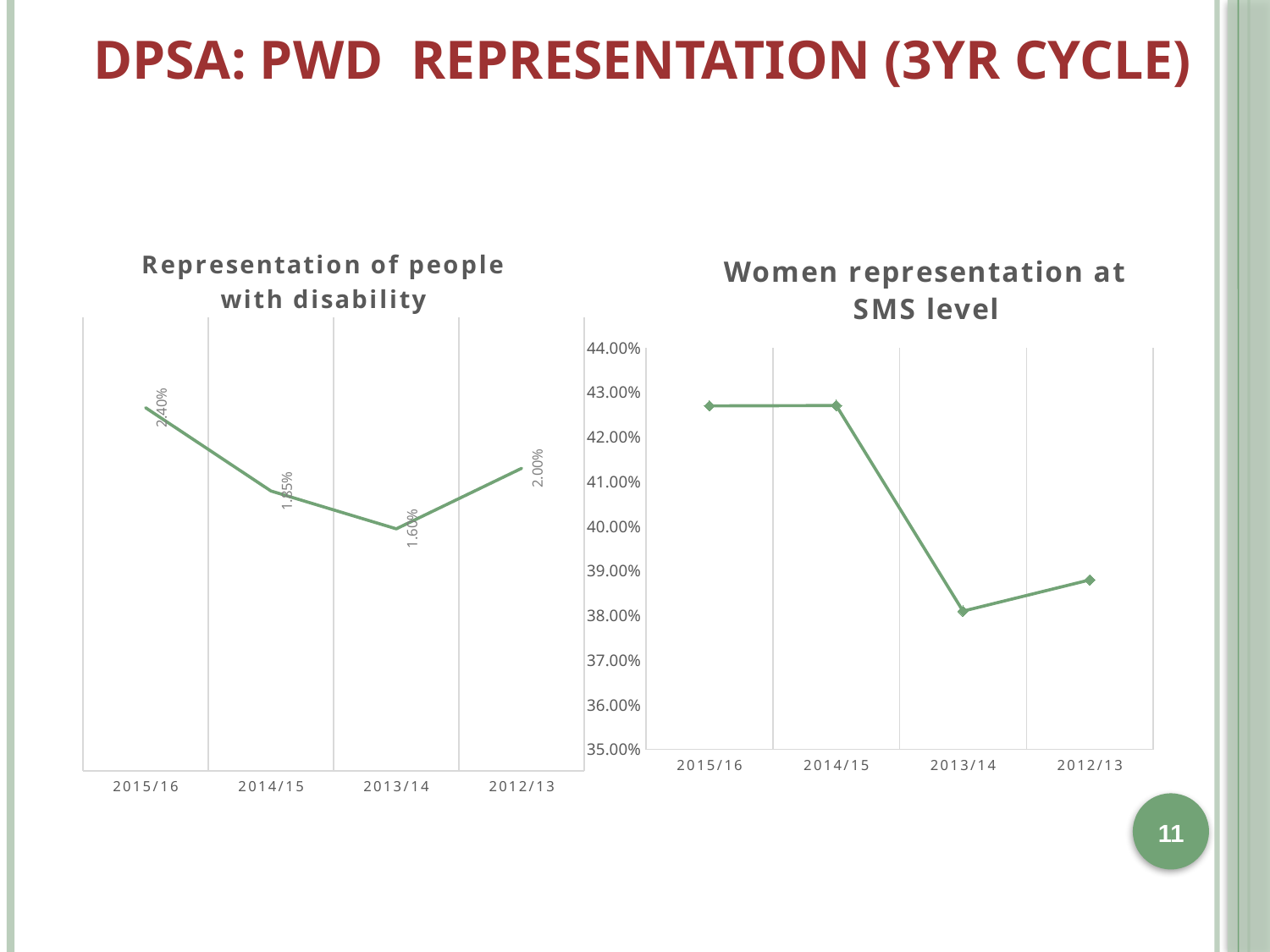
In the 'Representation of people with disability' chart, how many years are plotted? 4 What kind of chart is 'Women representation at SMS level'? Line chart In the 'Representation of people with disability' chart, what is the value for 2012/13? 2.00% In the 'Women representation at SMS level' chart, which is larger, the value for 2014/15 or the value for 2012/13? 2014/15 In the 'Women representation at SMS level' chart, is the value for 2013/14 greater or less than 39.00%? less In the 'Women representation at SMS level' chart, is the value for 2015/16 greater or less than 42.00%? greater In the 'Representation of people with disability' chart, what is the difference between the 2015/16 and 2014/15 values? 0.55% In the 'Representation of people with disability' chart, which year has the lowest value? 2013/14 In the 'Women representation at SMS level' chart, which year has the lowest value? 2013/14 In the 'Representation of people with disability' chart, which year has the highest value? 2015/16 In the 'Representation of people with disability' chart, what is the value for 2015/16? 2.40% In the 'Representation of people with disability' chart, what is the value for 2013/14? 1.60%